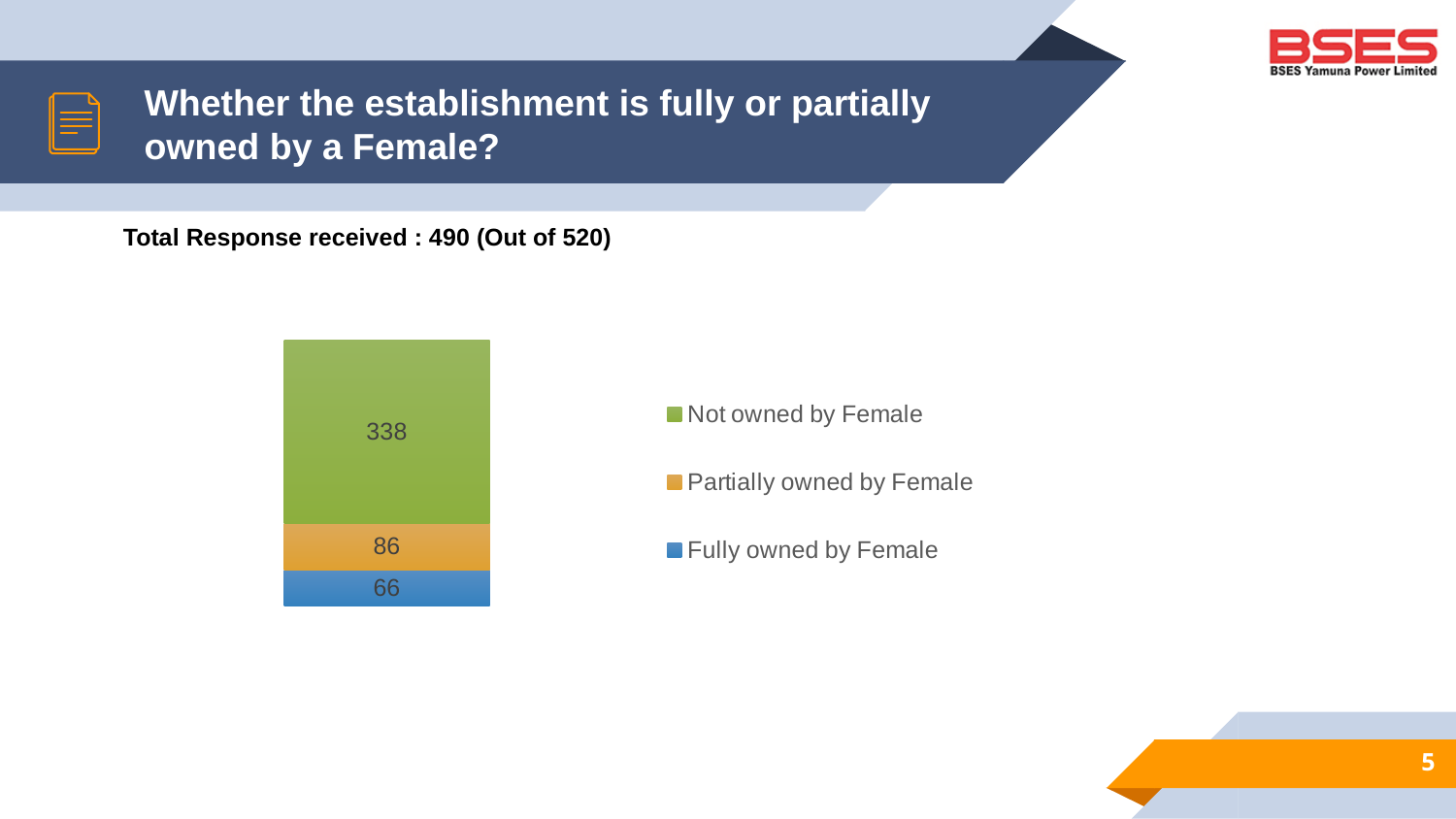
What is the total of the stacked bar? 490 What kind of chart is shown? Stacked bar chart What is the value for Not owned by Female? 338 What is the value for Fully owned by Female? 66 Which colour represents Fully owned by Female in the legend? Blue How many series does the legend list? 3 What is the value for Partially owned by Female? 86 Which is larger, Partially owned by Female or Fully owned by Female? Partially owned by Female What is the difference between Not owned by Female and Partially owned by Female? 252 What is the difference between Partially owned by Female and Fully owned by Female? 20 Which category has the highest value? Not owned by Female Which category has the lowest value? Fully owned by Female